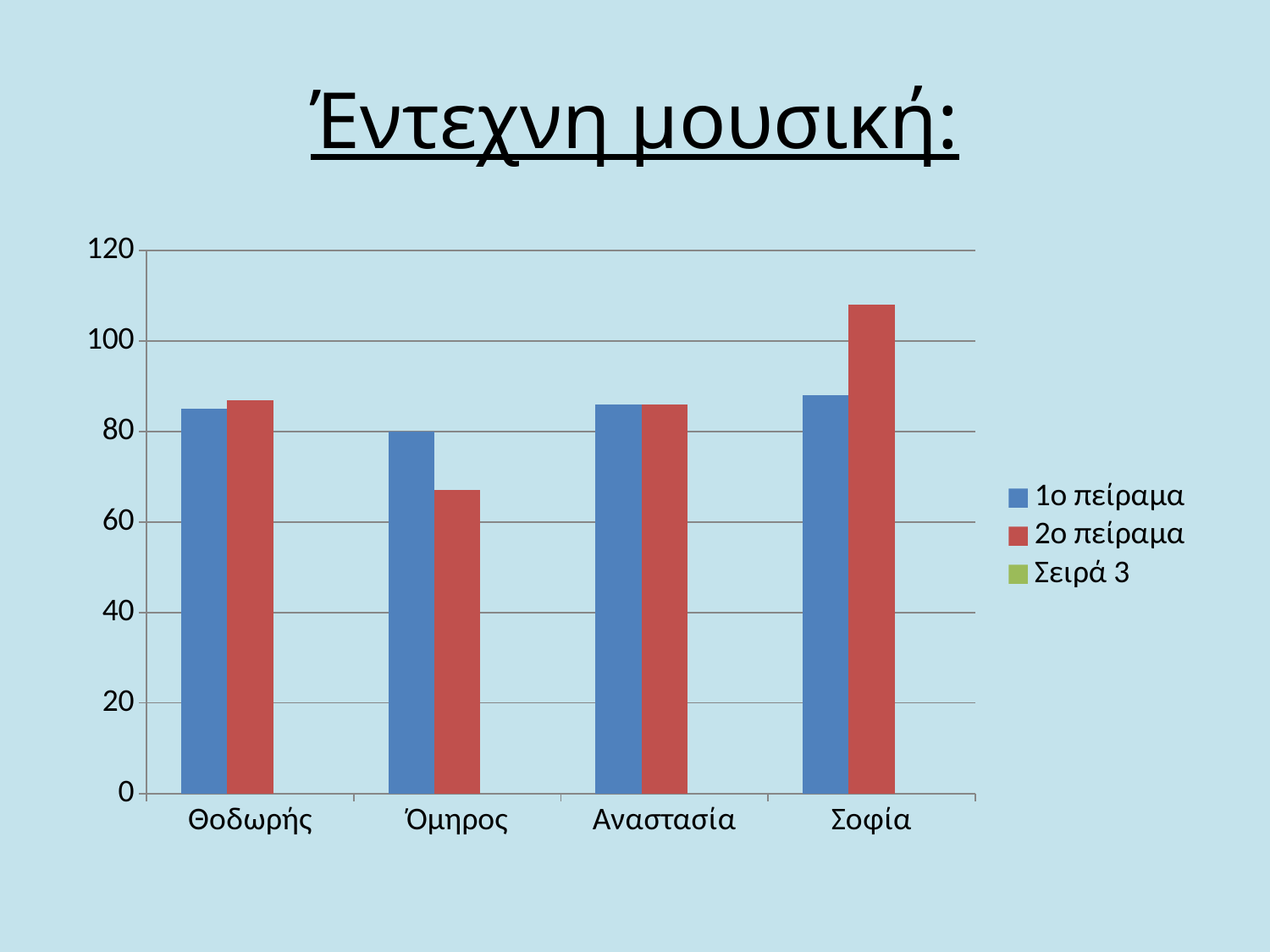
Is the value of 2ο πείραμα for Όμηρος greater or less than 80? less For Όμηρος, which is larger: 1ο πείραμα or 2ο πείραμα? 1ο πείραμα What is the title of the slide? Έντεχνη μουσική: For Σοφία, which is larger: 1ο πείραμα or 2ο πείραμα? 2ο πείραμα What type of chart is shown on the slide? bar chart Is the value of 2ο πείραμα for Σοφία greater or less than 100? greater Which category has the lowest value for 2ο πείραμα? Όμηρος What is the value of 1ο πείραμα for Όμηρος? 80 Which category has the lowest value for 1ο πείραμα? Όμηρος How many categories are shown on the x axis? 4 How many series does the legend list? 3 Which category has the highest value for 2ο πείραμα? Σοφία